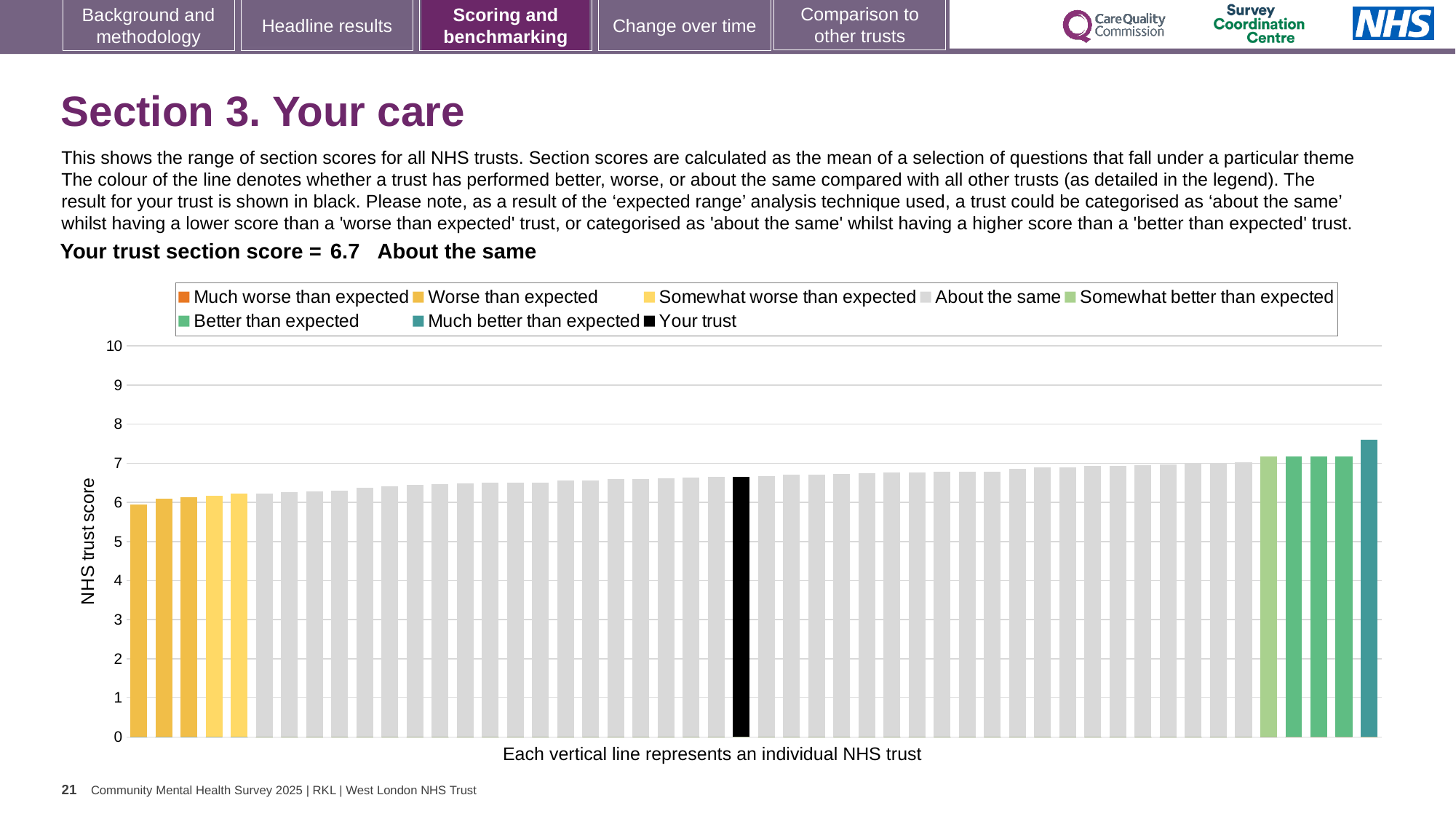
Is the value of the tallest bar (rightmost) greater or less than 7? greater What is the section score for your trust shown on the slide? 6.7 How many entries does the chart legend list? 8 Is the value of the tallest bar (rightmost) greater or less than 8? less What is the label on the vertical axis of the chart? NHS trust score Is the value of the black bar (your trust) greater or less than 6? greater How is your trust's section score categorised compared with other trusts? About the same Do the bar values rise or fall from left to right along the x axis? Rise What kind of chart is shown on the slide? Bar chart Which bar is the highest: the leftmost bar or the rightmost bar? The rightmost bar According to the legend, which category is shown in black? Your trust